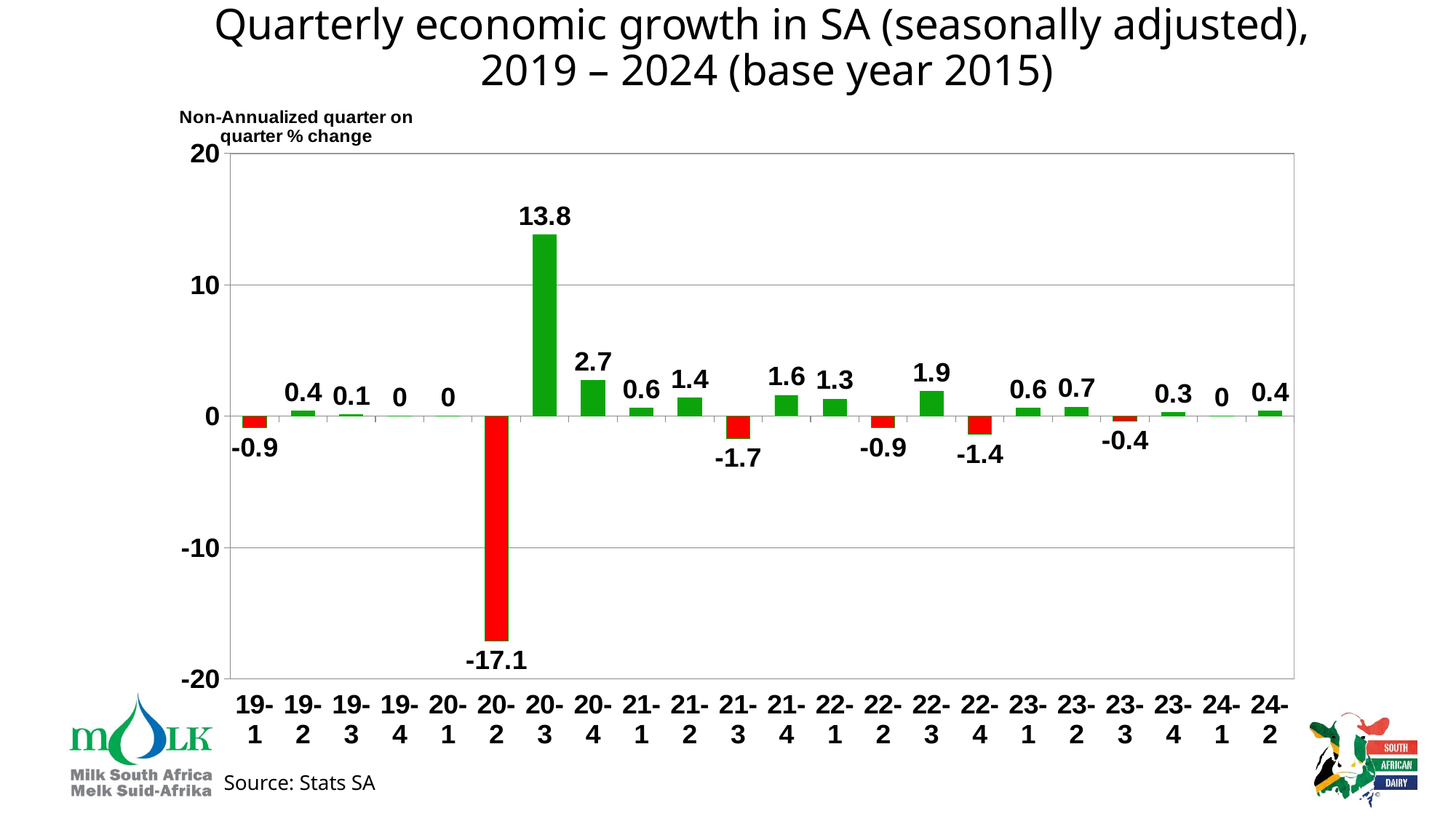
Which quarter has the highest value? 20-3 Is the value for 20-2 greater or less than -10? less What is the source cited below the chart? Stats SA What is the value for 22-3? 1.9 What is the difference between the values for 20-3 and 20-4? 11.1 What is the value for 20-3? 13.8 Which quarter has the lowest value? 20-2 Which is larger, the value for 21-4 or the value for 22-1? 21-4 What is the value for 20-2? -17.1 What is the value for 24-2? 0.4 What kind of chart is this? bar chart How many quarters are shown on the x axis? 22